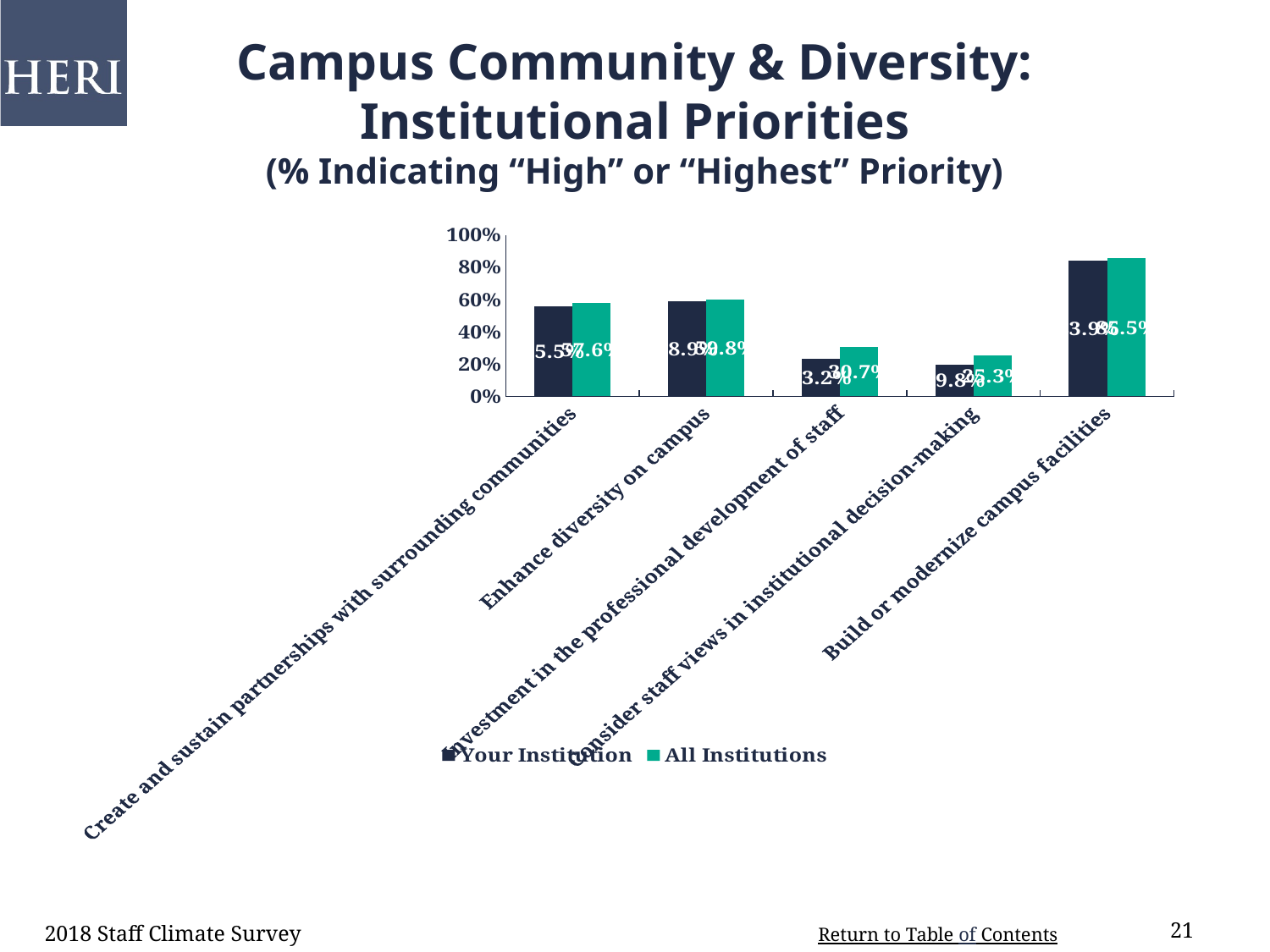
What are the two series named in the chart's legend? Your Institution and All Institutions For Your Institution, which category has the larger value, 'Build or modernize campus facilities' or 'Enhance diversity on campus'? Build or modernize campus facilities For 'Investment in the professional development of staff', which series has the larger value, Your Institution or All Institutions? All Institutions Is the value for Your Institution on 'Build or modernize campus facilities' greater or less than 80%? greater Is the value for All Institutions on 'Investment in the professional development of staff' greater or less than 40%? less Is the value for Your Institution on 'Consider staff views in institutional decision-making' greater or less than 40%? less How many categories are shown on the x axis of the chart? 5 How many series does the chart's legend list? 2 Which category has the lowest value for All Institutions? Consider staff views in institutional decision-making What kind of chart is shown on the slide? bar chart Which category has the highest value for Your Institution? Build or modernize campus facilities